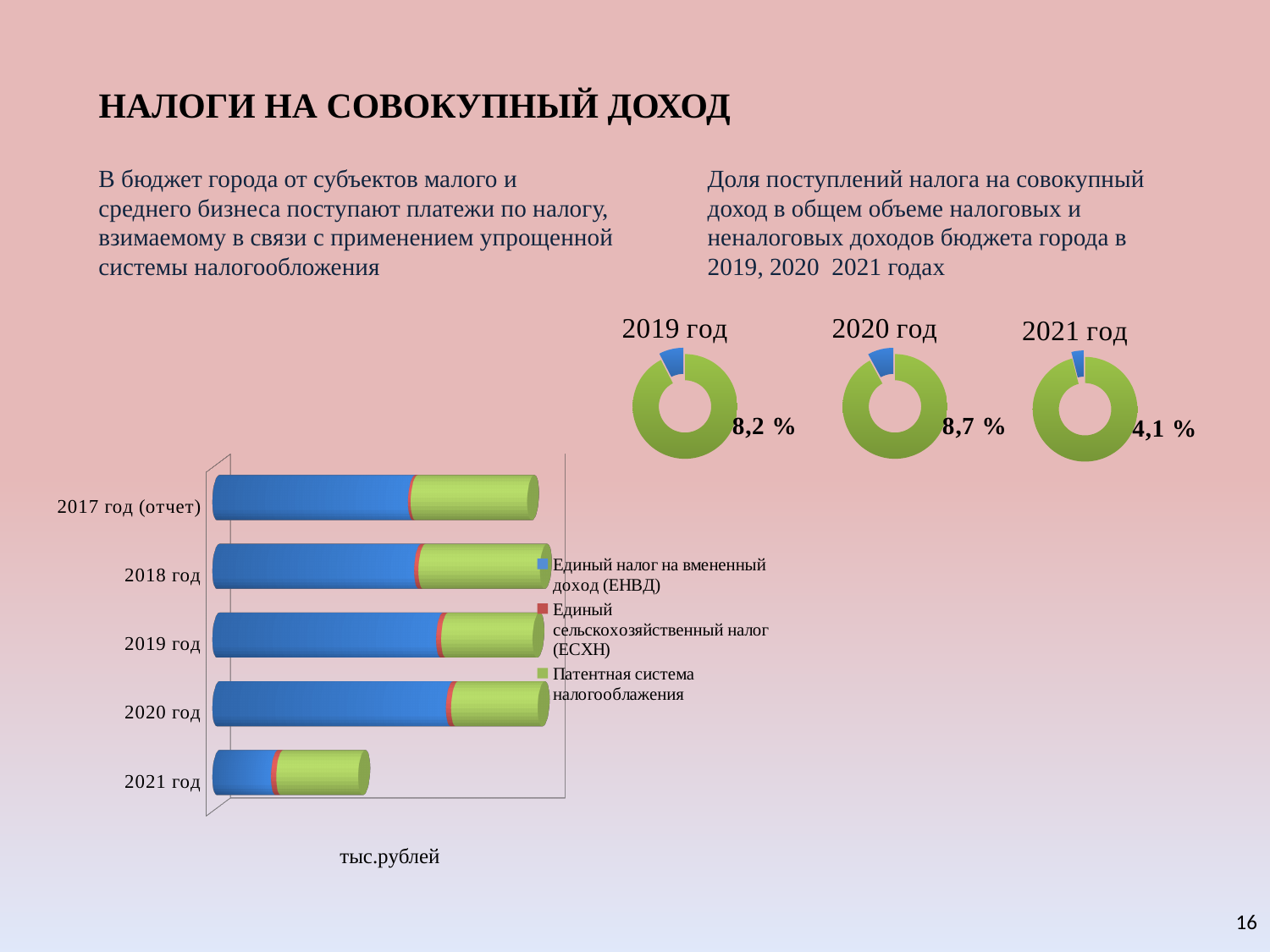
What kind of chart is the chart at the bottom left of the slide showing years 2017–2021? bar chart What is the difference between the share shown for 2020 год and the share shown for 2019 год in the donut charts? 0,5 % In the donut chart labelled 2020 год, what share is printed next to the chart? 8,7 % Among the three donut charts (2019, 2020, 2021), which year shows the highest share? 2020 год In the bar chart at the bottom left, how many series does the legend list? 3 In the bar chart at the bottom left, is the total bar for 2020 год longer or shorter than the bar for 2021 год? longer In the bar chart at the bottom left, which series is shown in green according to the legend? Патентная система налогооблажения In the donut chart labelled 2019 год, what share is printed next to the chart? 8,2 % In the bar chart at the bottom left, how many year categories are shown? 5 In the bar chart at the bottom left, which year has the shortest total bar? 2021 год In the bar chart at the bottom left, what unit is stated below the chart? тыс.рублей In the donut chart labelled 2021 год, what share is printed next to the chart? 4,1 %